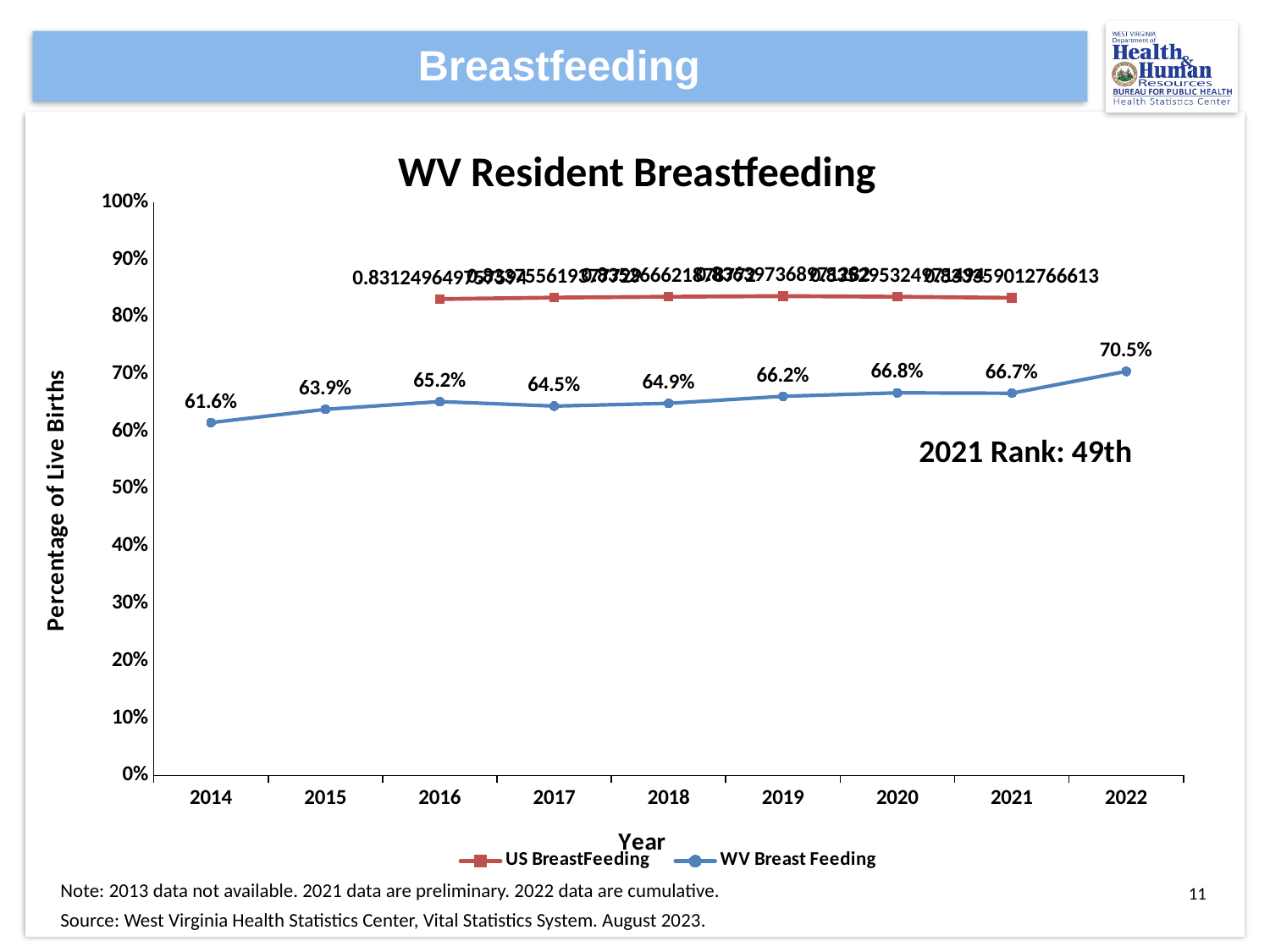
Which year has the highest WV Breast Feeding value? 2022 Is the US BreastFeeding value for 2018 greater or less than 80%? greater What is the title of the chart? WV Resident Breastfeeding What is the WV Breast Feeding value for 2019? 66.2% How many series does the legend list? 2 What is the WV Breast Feeding value for 2014? 61.6% What is the difference between the WV Breast Feeding values for 2022 and 2014? 8.9% How many years are shown on the x axis? 9 What is the WV Breast Feeding value for 2022? 70.5% Which is larger, the WV Breast Feeding value for 2016 or for 2017? 2016 Which year has the lowest WV Breast Feeding value? 2014 What type of chart is shown on the slide? Line chart